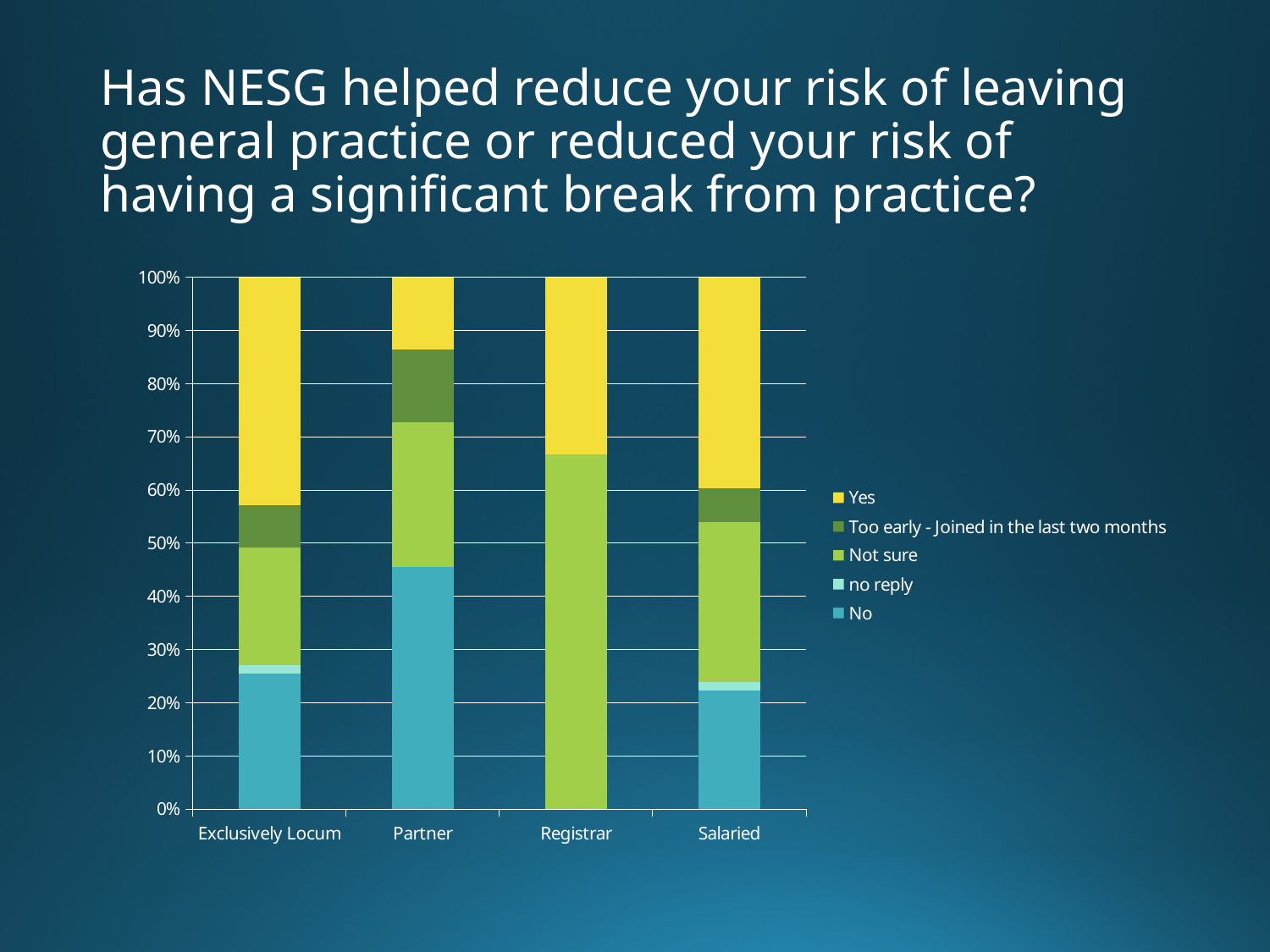
Is the 'Yes' share for Partner greater or less than 20%? less How many series does the chart's legend list? 5 What kind of chart is shown on the slide? Stacked bar chart What does each stacked bar total on the y axis? 100% How many categories are shown on the x axis of the chart? 4 Which category has the largest 'Not sure' segment? Registrar Which category has the largest 'No' segment? Partner Is the 'No' share for Partner greater or less than 40%? greater Is the 'Not sure' share for Registrar greater or less than 60%? greater Which has the larger 'Yes' share, Registrar or Partner? Registrar Which colour represents 'Yes' in the legend? Yellow Which category has the smallest 'Yes' segment? Partner